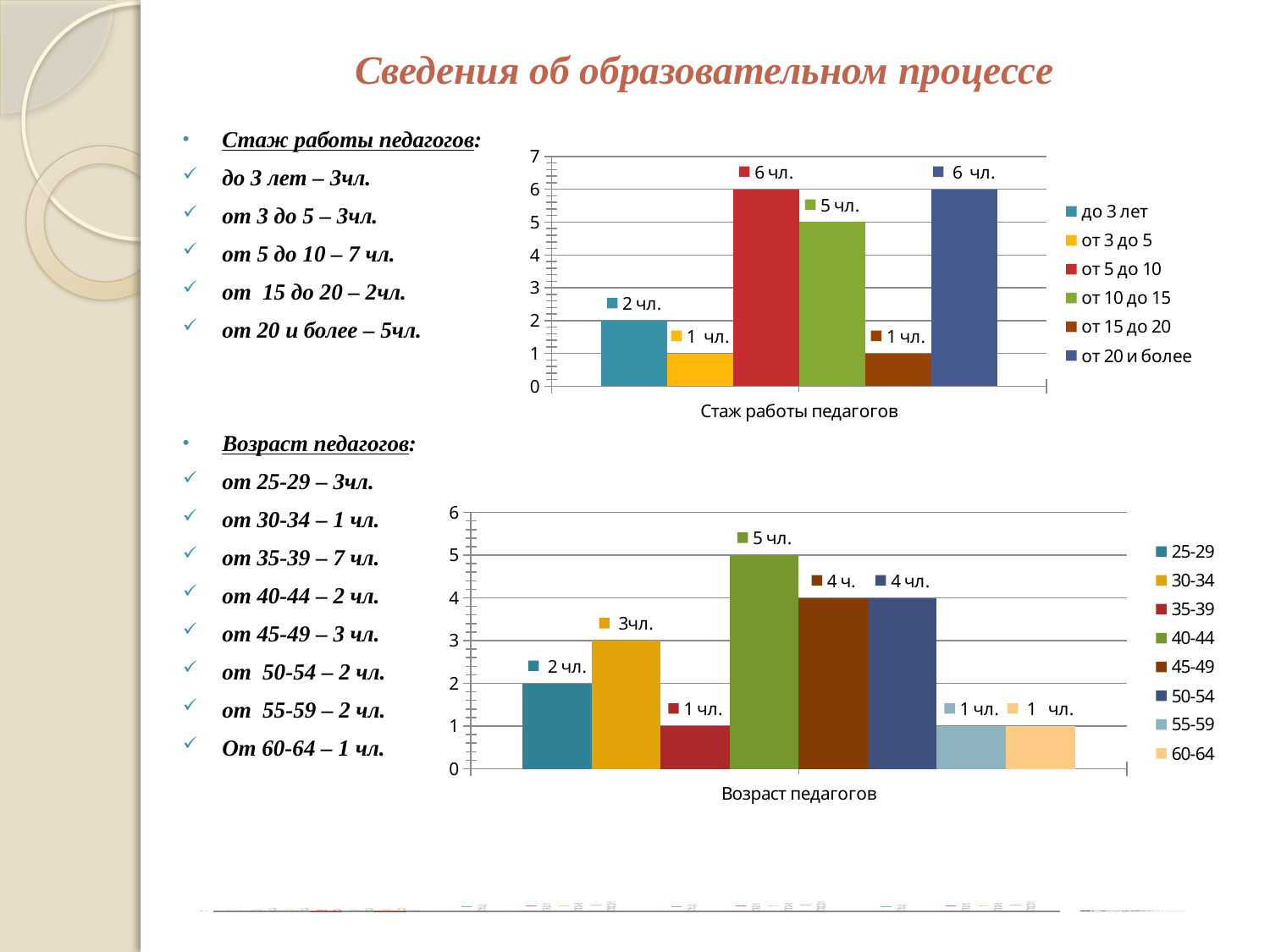
In the chart titled 'Возраст педагогов', what is the value for '30-34'? 3чл. In the chart titled 'Возраст педагогов', how many series does the legend list? 8 In the chart titled 'Возраст педагогов', which category has the highest value? 40-44 In the chart titled 'Стаж работы педагогов', how many series does the legend list? 6 In the chart titled 'Стаж работы педагогов', what is the value for 'до 3 лет'? 2 чл. In the chart titled 'Возраст педагогов', what colour is the bar for '40-44'? green In the chart titled 'Стаж работы педагогов', what is the difference between 'от 5 до 10' and 'от 3 до 5'? 5 In the chart titled 'Стаж работы педагогов', which is larger, 'от 10 до 15' or 'от 15 до 20'? от 10 до 15 In the chart titled 'Стаж работы педагогов', what kind of chart is it? bar chart In the chart titled 'Возраст педагогов', what is the difference between '40-44' and '25-29'? 3 In the chart titled 'Стаж работы педагогов', what is the value for 'от 5 до 10'? 6 чл. In the chart titled 'Возраст педагогов', what is the value for '45-49'? 4 ч.